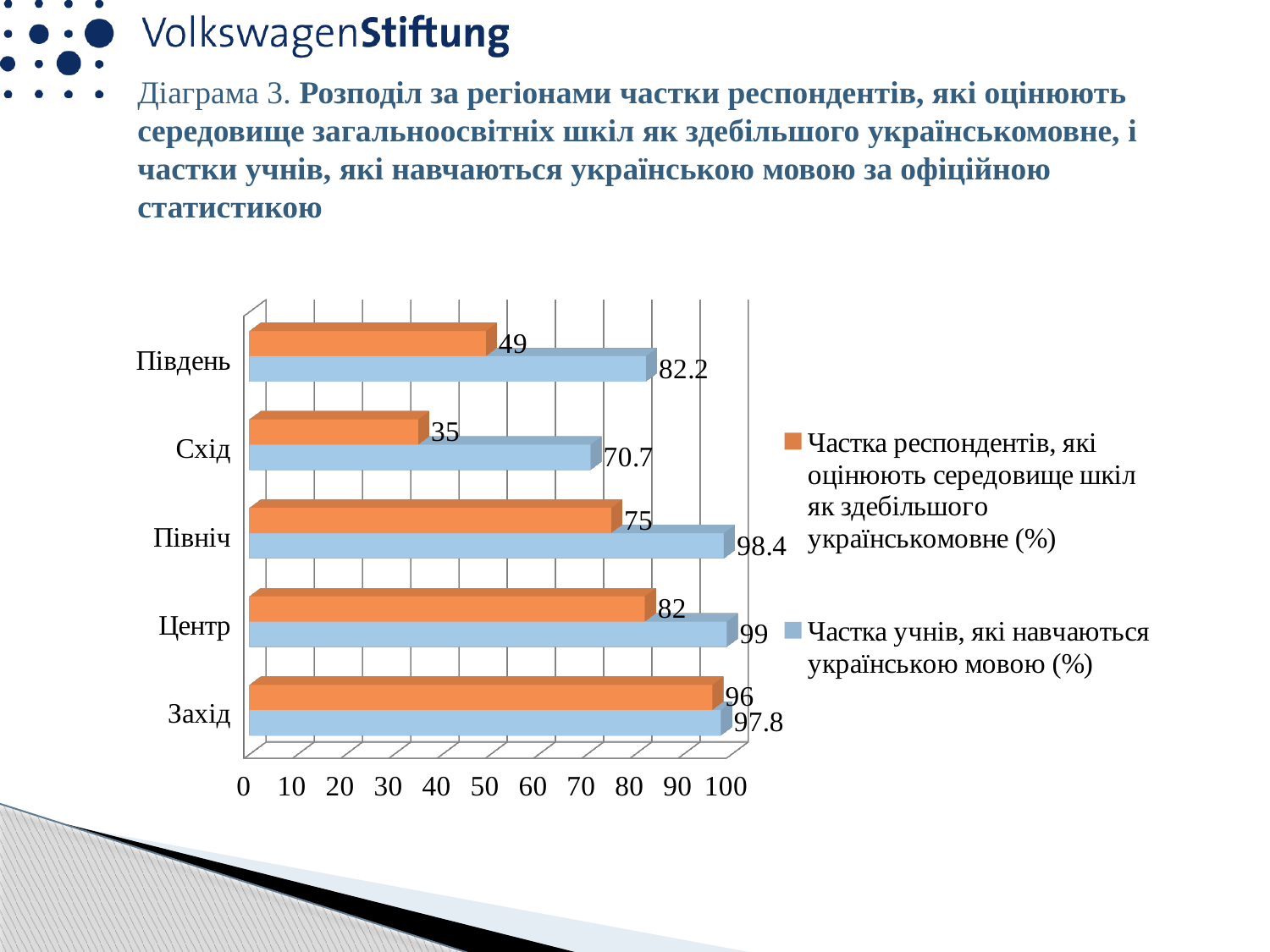
What is the share of pupils studying in Ukrainian for Північ? 98.4 What is the share of pupils studying in Ukrainian for Південь? 82.2 What type of chart is shown on the slide? bar chart Which is larger for Центр: the share of respondents or the share of pupils studying in Ukrainian? share of pupils studying in Ukrainian (99) How many series does the legend list? 2 Is the share of respondents for Північ greater or less than 70? greater Which region has the lowest share of pupils studying in Ukrainian? Схід Which region has the highest share of respondents who assess the school environment as mostly Ukrainian-speaking? Захід What is the share of respondents who assess the school environment as mostly Ukrainian-speaking for Схід? 35 How many regions (categories) are shown on the chart? 5 Which colour represents the share of pupils studying in Ukrainian? blue What is the difference between the share of pupils studying in Ukrainian and the share of respondents for Південь? 33.2